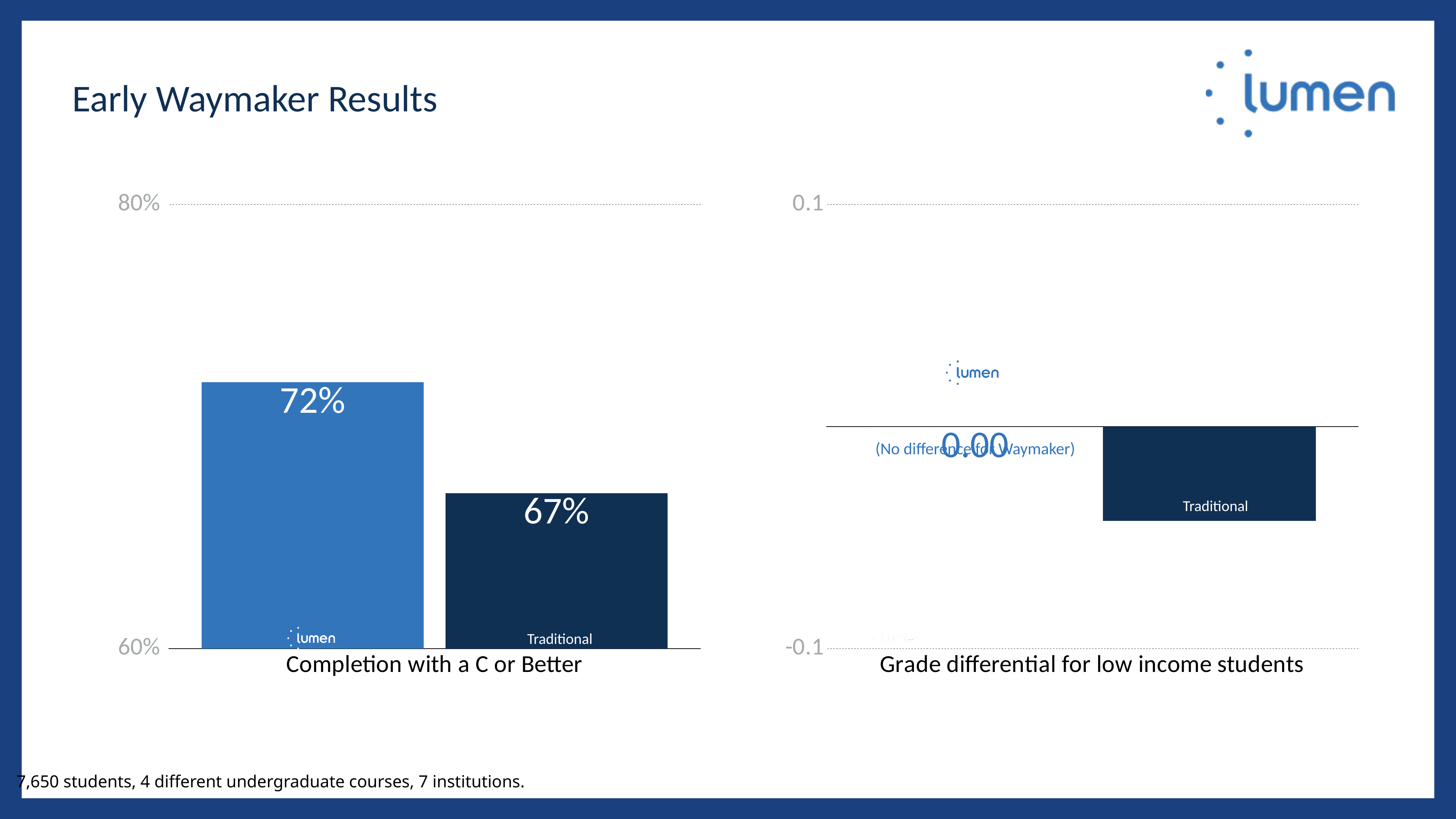
In the 'Grade differential for low income students' chart, is the value for Traditional greater or less than -0.1? greater In the 'Grade differential for low income students' chart, what is the value for Lumen? 0.00 In the 'Completion with a C or Better' chart, how many bars are plotted? 2 What type of chart is the 'Completion with a C or Better' chart? Bar chart In the 'Completion with a C or Better' chart, what is the completion rate for Lumen? 72% In the 'Completion with a C or Better' chart, what is the difference in percentage points between Lumen and Traditional? 5 percentage points In the 'Completion with a C or Better' chart, which bar is higher, Lumen or Traditional? Lumen In the 'Completion with a C or Better' chart, what is the completion rate for Traditional? 67% In the 'Grade differential for low income students' chart, which category has the lowest value? Traditional In the 'Completion with a C or Better' chart, which category has the lowest value? Traditional What is the title of the slide containing the two charts? Early Waymaker Results In the 'Grade differential for low income students' chart, what is the highest value shown on the vertical axis? 0.1